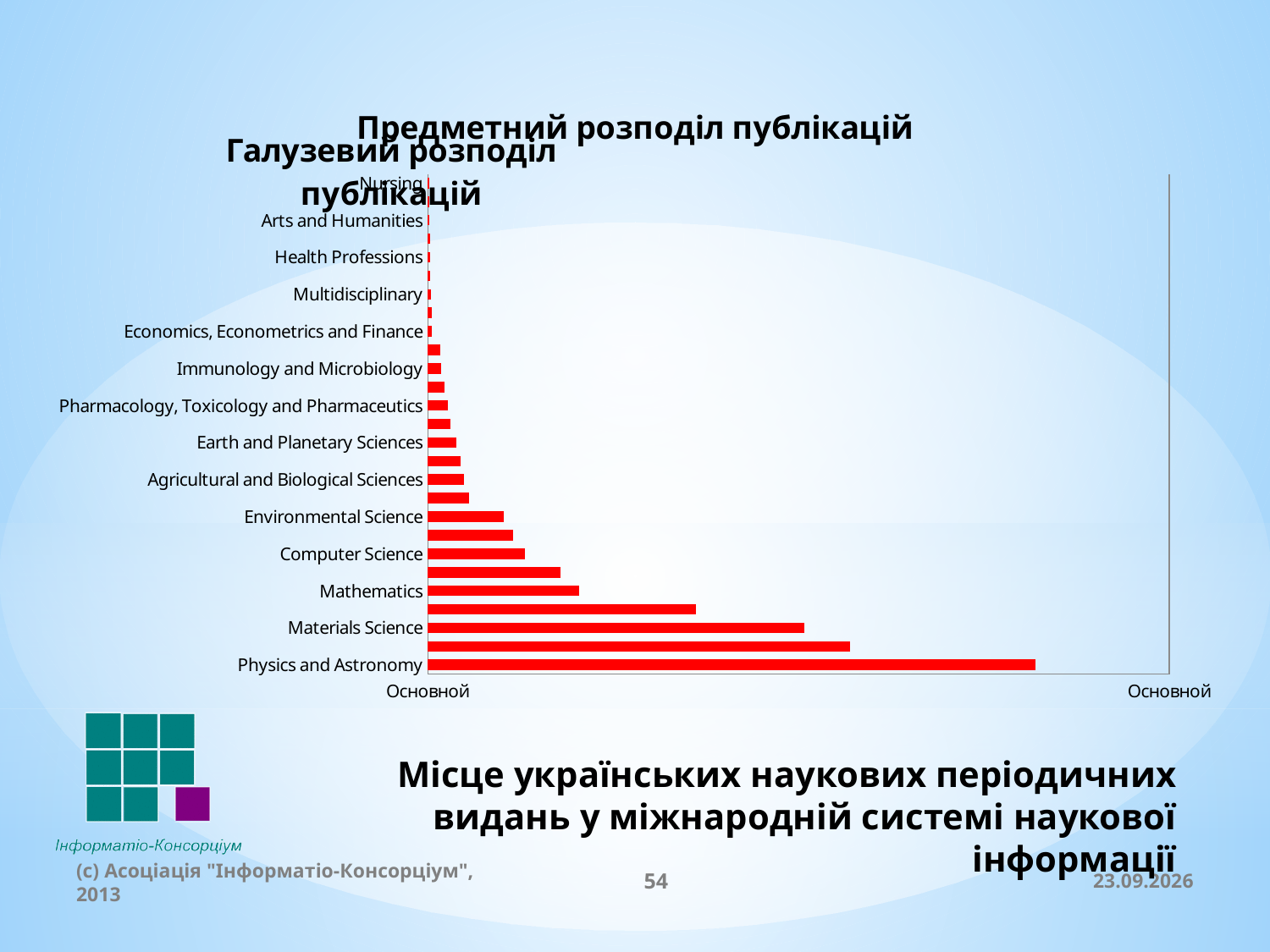
Which has the larger value, Environmental Science or Agricultural and Biological Sciences? Environmental Science Which has the larger value, Earth and Planetary Sciences or Arts and Humanities? Earth and Planetary Sciences What is the title of the chart? Предметний розподіл публікацій Which category has the highest value in the chart? Physics and Astronomy What kind of chart is shown on the slide? bar chart Which has the larger value, Immunology and Microbiology or Multidisciplinary? Immunology and Microbiology Which labelled category has the lowest value in the chart? Nursing What colour are the bars in the chart? red